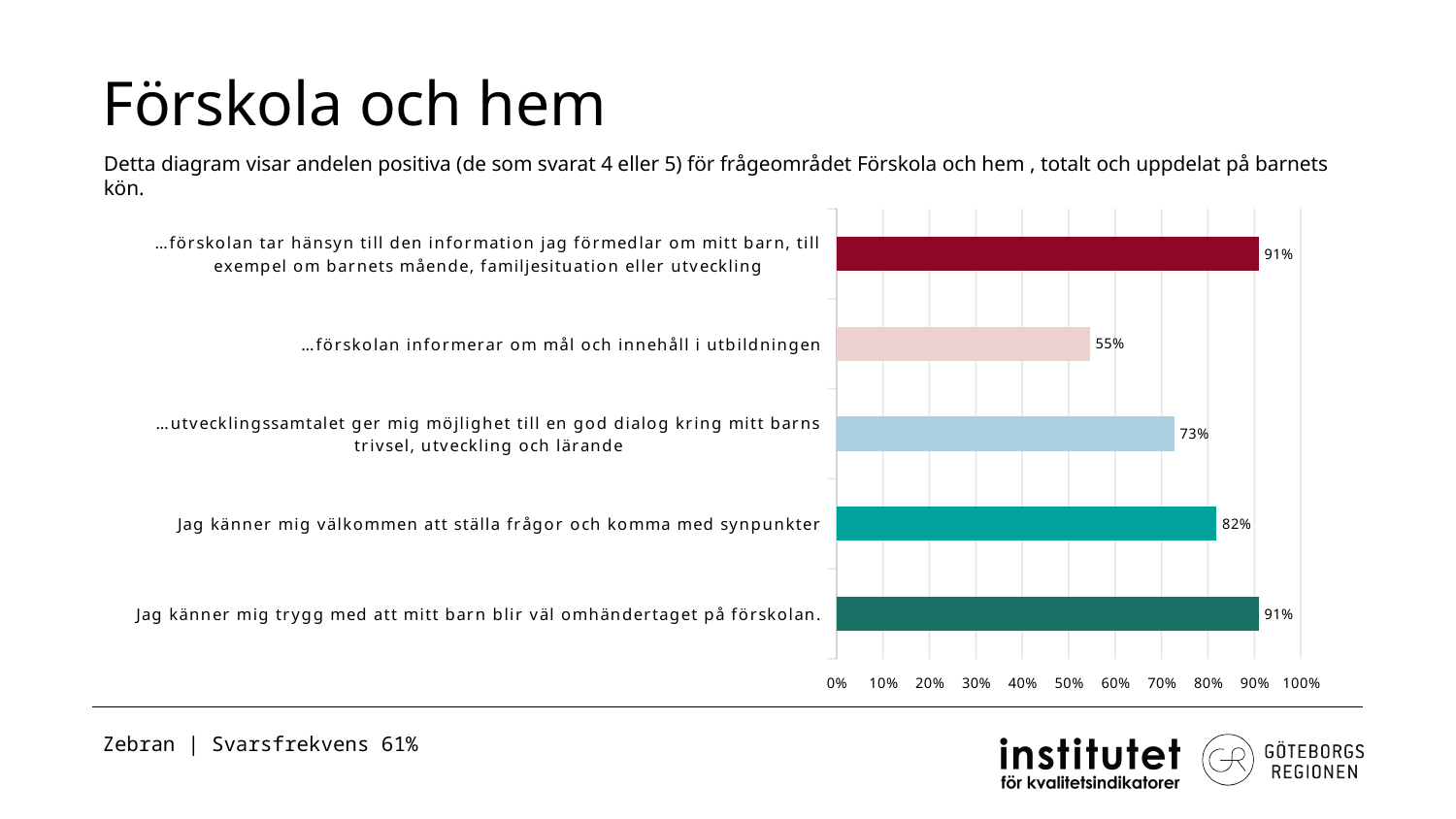
Is the value for "…förskolan informerar om mål och innehåll i utbildningen" greater or less than 60%? less Which category has the lowest value? …förskolan informerar om mål och innehåll i utbildningen What is the value for "…förskolan informerar om mål och innehåll i utbildningen"? 55% What is the difference between the value for "Jag känner mig trygg med att mitt barn blir väl omhändertaget på förskolan." and the value for "…utvecklingssamtalet ger mig möjlighet till en god dialog kring mitt barns trivsel, utveckling och lärande"? 18% What is the difference between the value for "Jag känner mig välkommen att ställa frågor och komma med synpunkter" and the value for "…förskolan informerar om mål och innehåll i utbildningen"? 27% What kind of chart is shown on the slide? bar chart What is the title of the slide containing the chart? Förskola och hem Which is larger: the value for "Jag känner mig välkommen att ställa frågor och komma med synpunkter" or the value for "…utvecklingssamtalet ger mig möjlighet till en god dialog kring mitt barns trivsel, utveckling och lärande"? Jag känner mig välkommen att ställa frågor och komma med synpunkter What is the value for "…utvecklingssamtalet ger mig möjlighet till en god dialog kring mitt barns trivsel, utveckling och lärande"? 73% What is the value for "Jag känner mig välkommen att ställa frågor och komma med synpunkter"? 82% How many categories are shown in the chart? 5 What is the value for "Jag känner mig trygg med att mitt barn blir väl omhändertaget på förskolan."? 91%